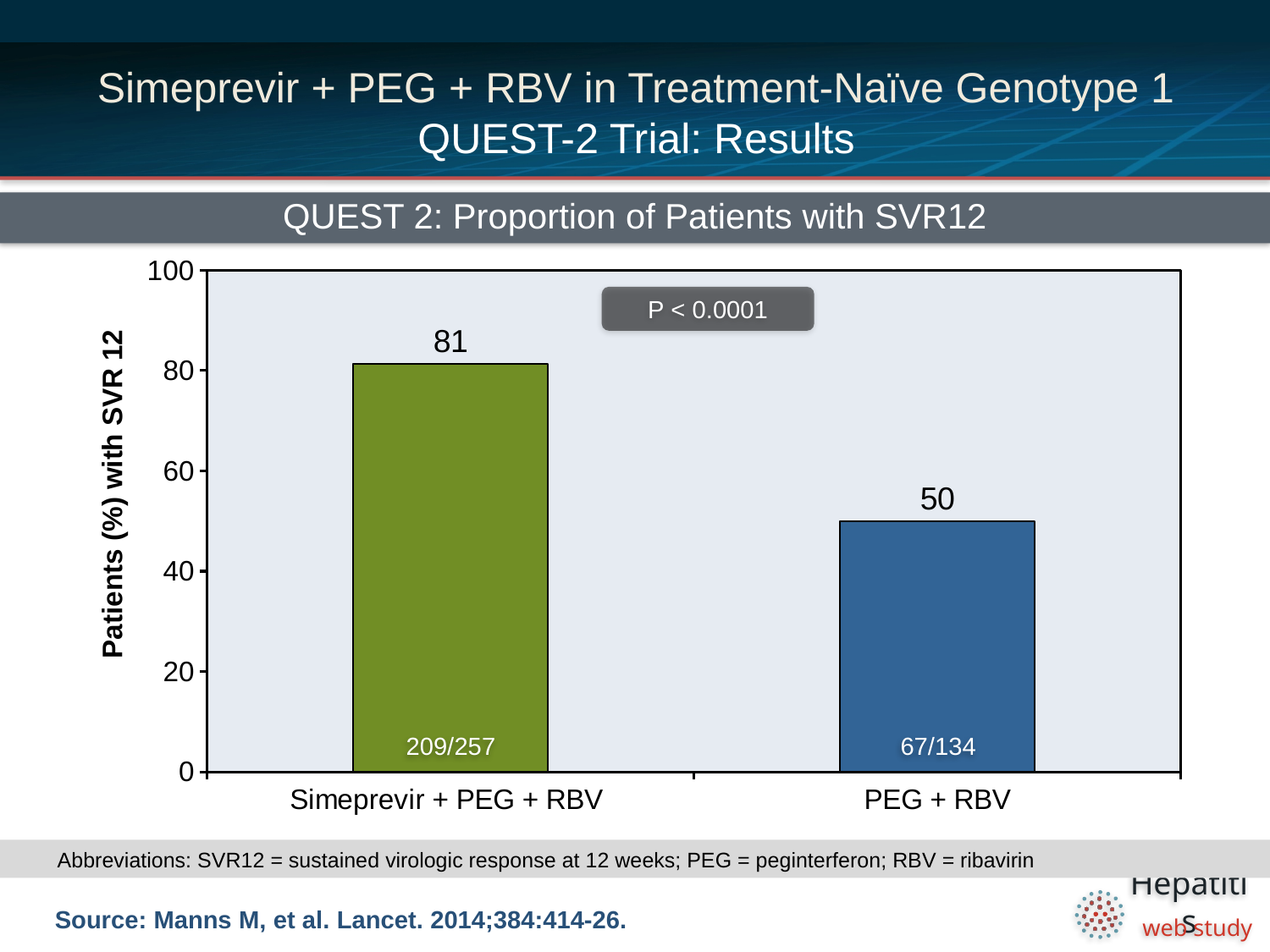
What fraction of patients is printed inside the PEG + RBV bar? 67/134 What kind of chart is shown? bar chart What is the value for PEG + RBV? 50 Is the value for Simeprevir + PEG + RBV greater or less than 60? greater What is the value for Simeprevir + PEG + RBV? 81 What is the difference between the values for Simeprevir + PEG + RBV and PEG + RBV? 31 How many categories are shown on the x axis? 2 Which is larger, the value for Simeprevir + PEG + RBV or the value for PEG + RBV? Simeprevir + PEG + RBV What fraction of patients is printed inside the Simeprevir + PEG + RBV bar? 209/257 What is the title of the chart? QUEST 2: Proportion of Patients with SVR12 Which category has the highest value? Simeprevir + PEG + RBV Which category has the lowest value? PEG + RBV